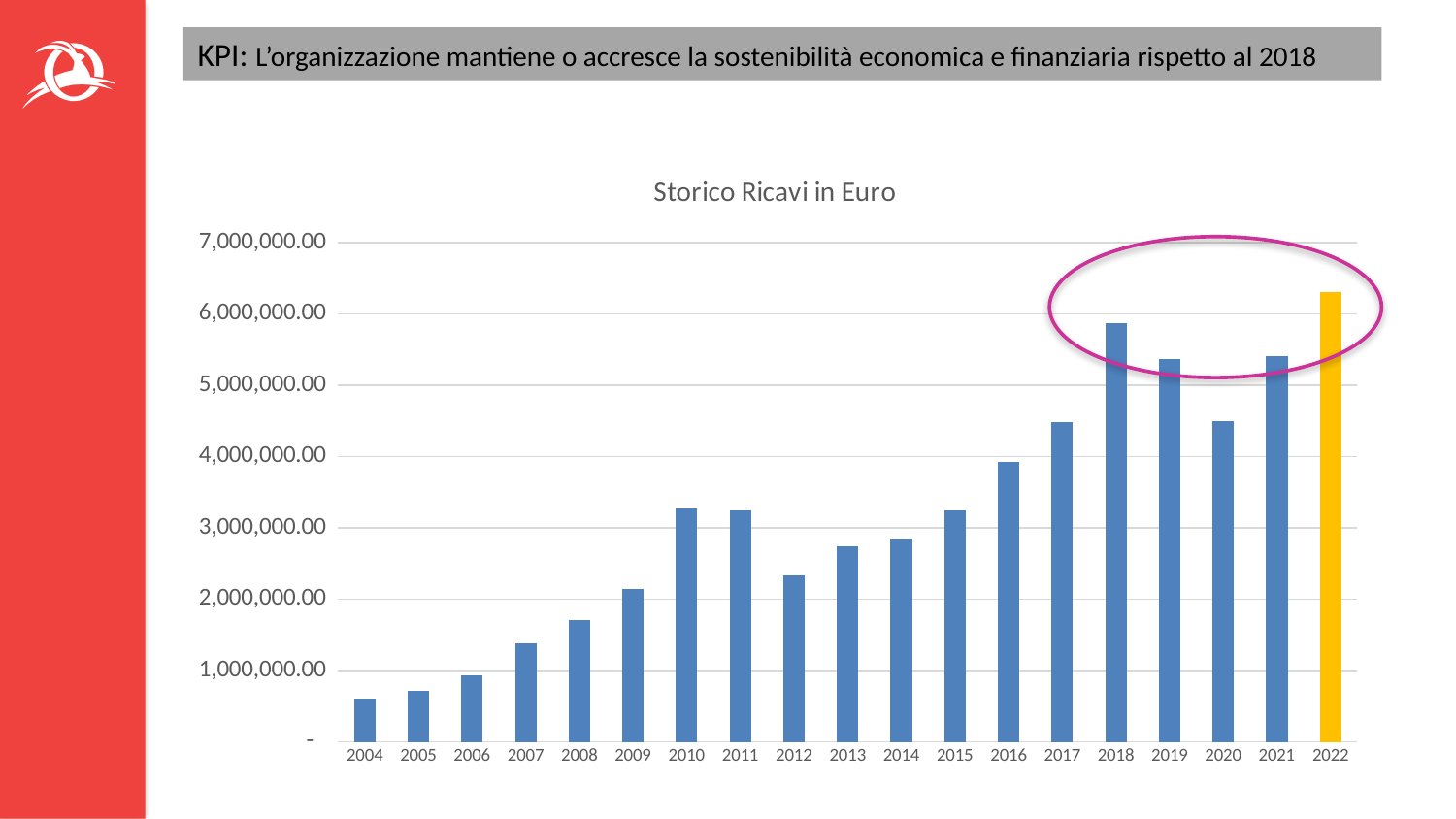
Is the value for 2016 greater or less than 4,000,000.00? less Is the value for 2018 greater or less than 5,000,000.00? greater Which year has the larger revenue, 2020 or 2021? 2021 What kind of chart is shown on the slide? Bar chart Is the value for 2020 greater or less than 5,000,000.00? less Which year has the lowest revenue in the chart? 2004 Which bar in the chart is coloured differently (yellow) from the others? 2022 Which year has the larger revenue, 2018 or 2019? 2018 How many years are plotted on the x axis of the chart? 19 Which year has the highest revenue in the chart? 2022 What is the title of the chart? Storico Ricavi in Euro